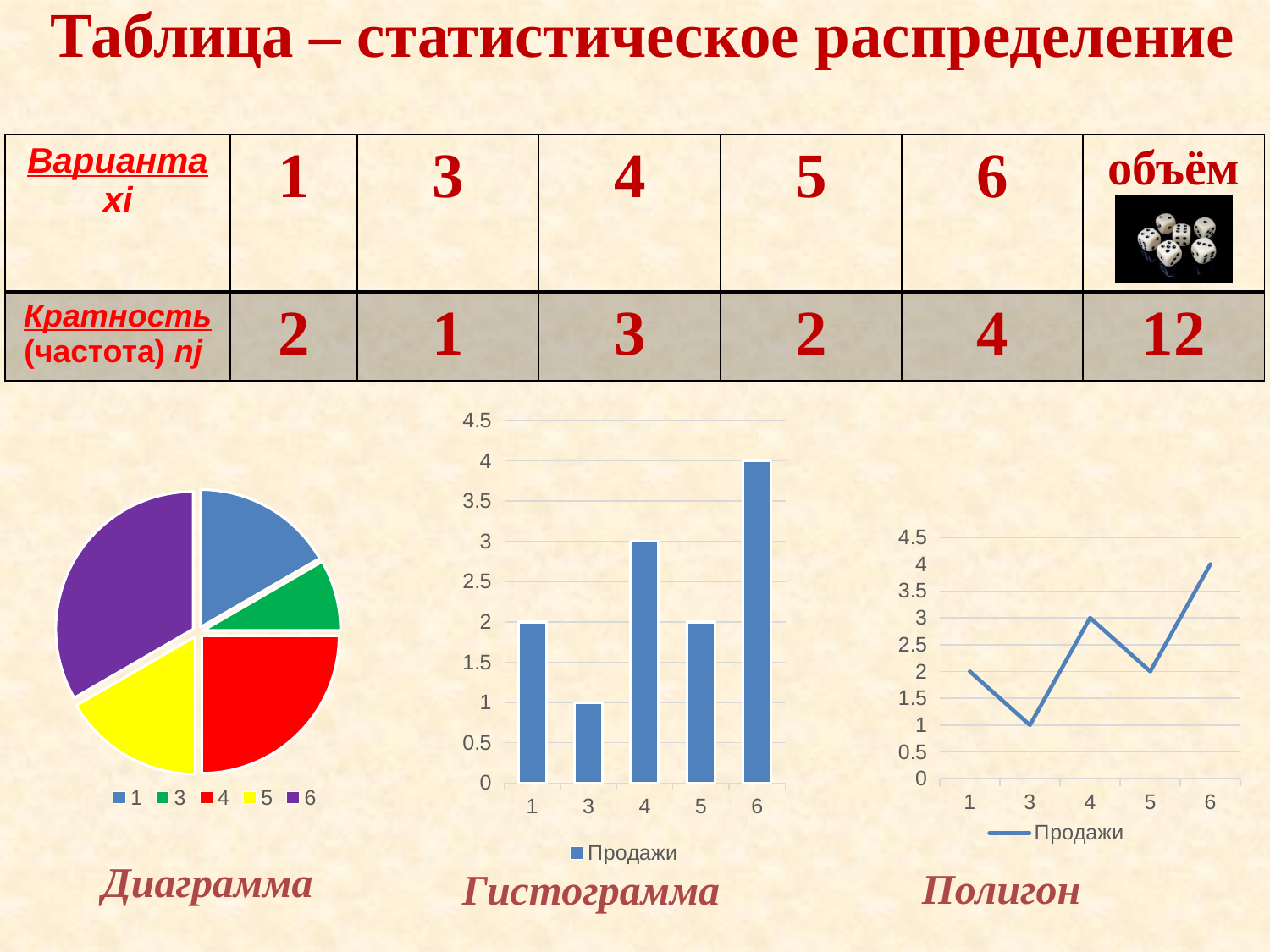
What kind of chart is the chart labelled Гистограмма? bar chart In the Гистограмма bar chart, what is the value for category 3? 1 In the Полигон line chart, which is larger, the value at category 1 or the value at category 3? category 1 In the Полигон line chart, what is the value at category 4? 3 In the Гистограмма bar chart, which category has the lowest bar? 3 In the Гистограмма bar chart, what is the value for category 6? 4 In the Гистограмма bar chart, which category has the highest bar? 6 What kind of chart is the chart labelled Диаграмма? pie chart In the Диаграмма pie chart, which category has the largest slice? 6 What kind of chart is the chart labelled Полигон? line chart How many categories are shown on the x axis of the Гистограмма bar chart? 5 In the Гистограмма bar chart, what is the difference between the values for category 6 and category 4? 1